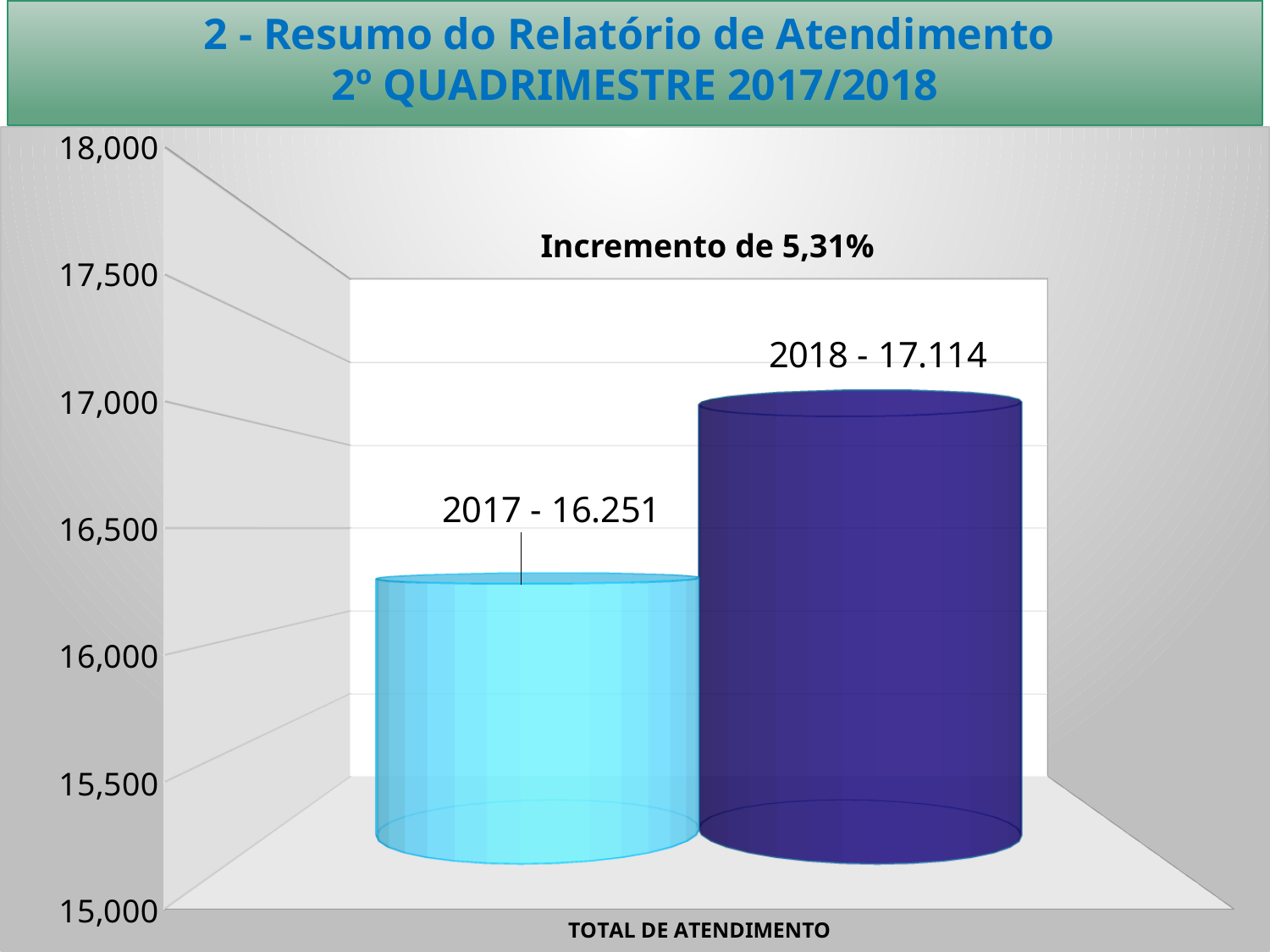
Which year has the higher total de atendimento? 2018 What percentage increase is stated in the chart title? 5,31% Is the value for 2018 greater or less than 17,000? greater Which year has the lower total de atendimento? 2017 What is the value for 2017? 16.251 What is the difference between the 2018 value and the 2017 value? 863 Do the values rise or fall from 2017 to 2018? rise How many bars are plotted in the chart? 2 What kind of chart is shown on the slide? bar chart What is the value for 2018? 17.114 Is the value for 2017 greater or less than 16,500? less What is the label shown below the bars on the horizontal axis? TOTAL DE ATENDIMENTO